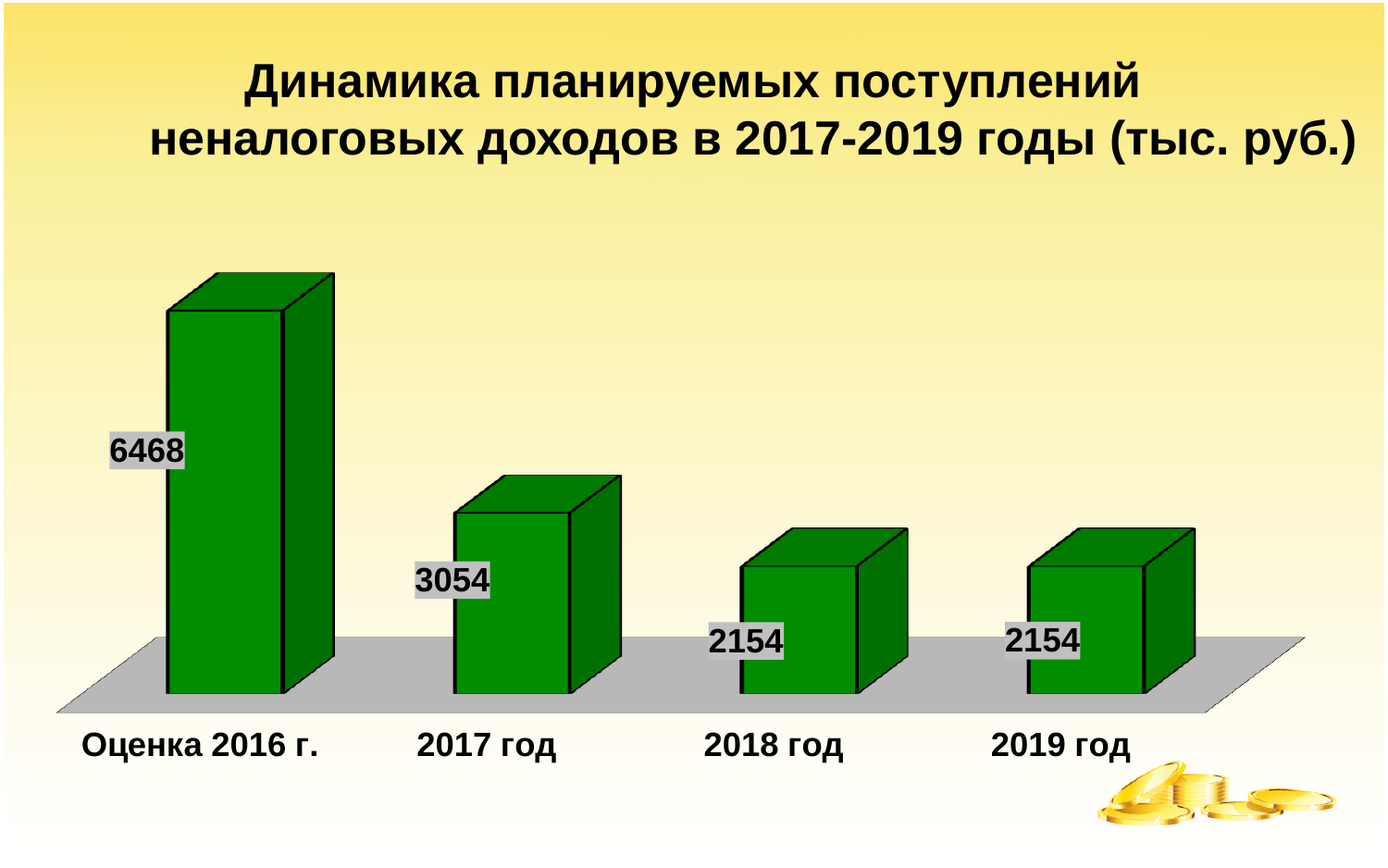
Do the values rise or fall from Оценка 2016 г. to 2018 год? fall Which category has the highest value? Оценка 2016 г. How many categories are shown on the chart? 4 What is the difference between the values for Оценка 2016 г. and 2017 год? 3414 What is the value for 2018 год? 2154 What is the title of the chart? Динамика планируемых поступлений неналоговых доходов в 2017-2019 годы (тыс. руб.) What is the value for 2017 год? 3054 Which is larger, the value for 2017 год or the value for 2019 год? 2017 год What is the value for Оценка 2016 г.? 6468 What kind of chart is shown on the slide? bar chart What is the difference between the values for 2017 год and 2018 год? 900 What is the value for 2019 год? 2154